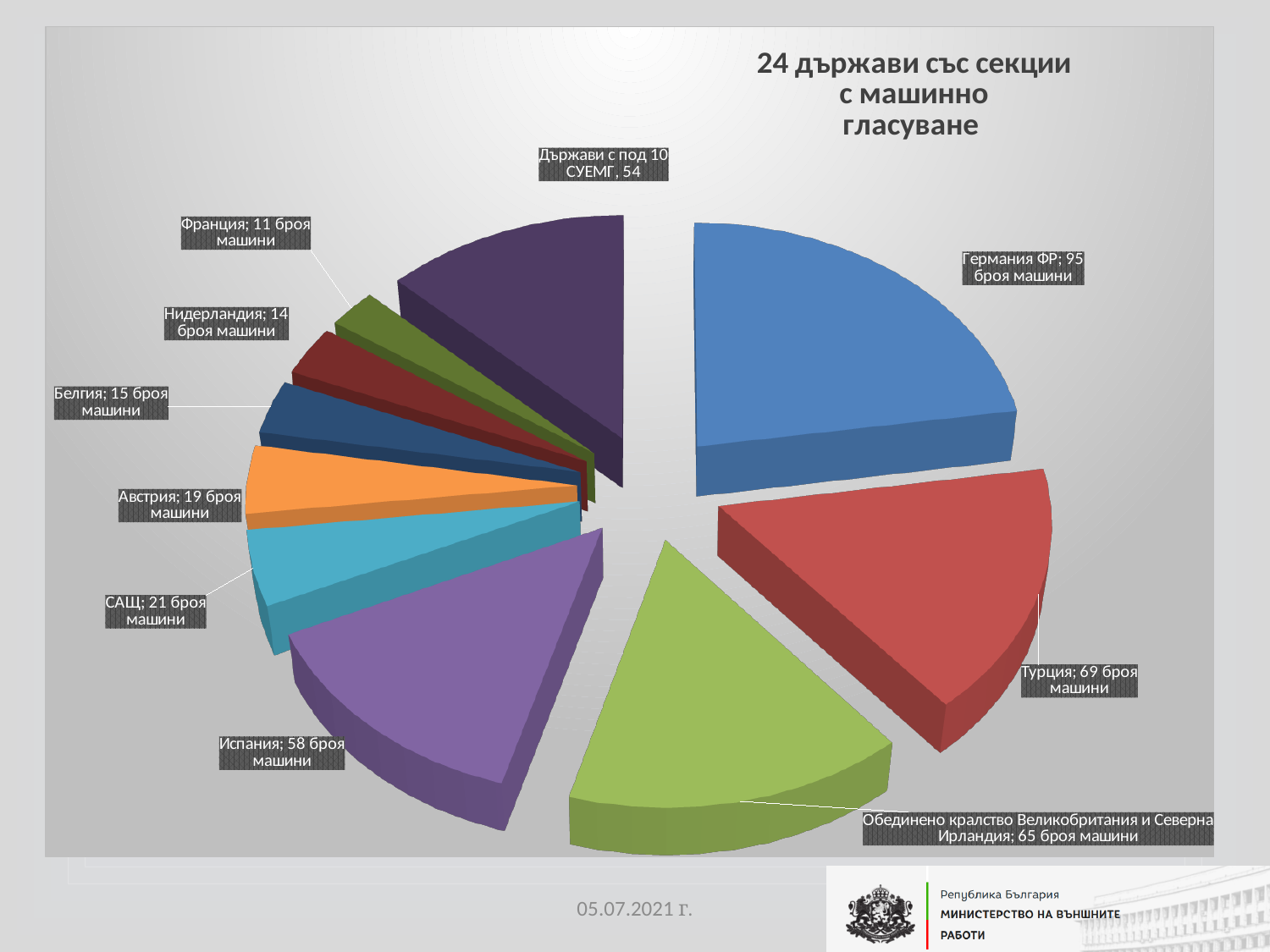
What type of chart is shown on the slide? Pie chart Which country has the largest slice in the pie chart? Германия ФР What value is shown for Обединено кралство Великобритания и Северна Ирландия? 65 броя машини Which slice has the smallest value in the pie chart? Франция How many machines are shown for Германия ФР? 95 броя машини What is the title of the chart? 24 държави със секции с машинно гласуване How many slices does the pie chart have? 10 What is the difference in the number of machines between Австрия and Белгия? 4 What is the difference in the number of machines between Германия ФР and Турция? 26 Which has more machines, Испания or САЩ? Испания How many machines are shown for Турция? 69 броя машини What value is shown for the slice labelled Държави с под 10 СУЕМГ? 54